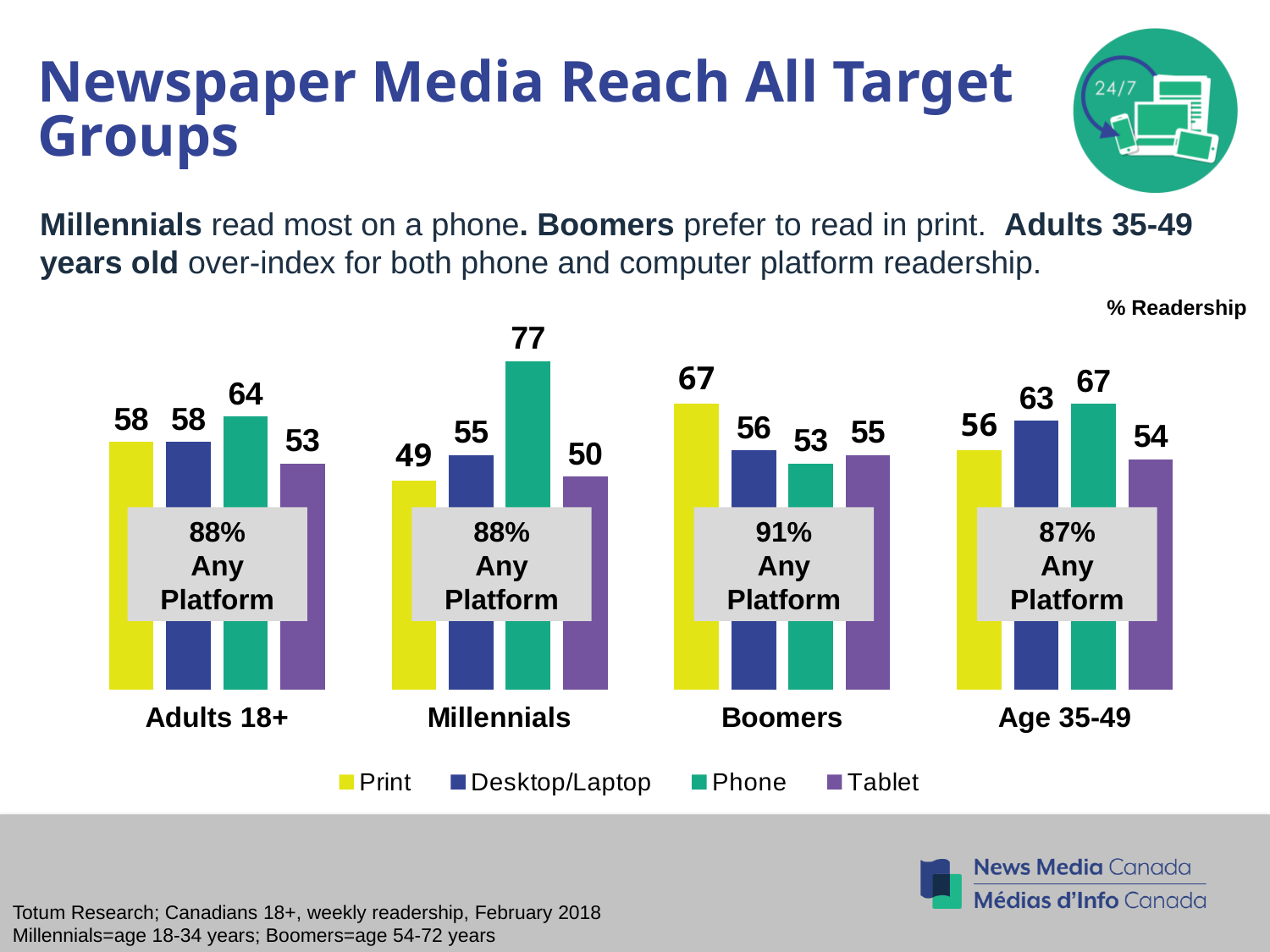
What is the Desktop/Laptop readership value for Age 35-49? 63 How many series does the chart legend list? 4 What is the difference between the Phone and Print readership values for Millennials? 28 What is the Tablet readership value for Adults 18+? 53 What is the Phone readership value for Millennials? 77 Which platform has the highest readership among Millennials? Phone How many age groups are shown on the x axis of the chart? 4 Which platform has the lowest readership among Boomers? Phone What is the Print readership value for Boomers? 67 What kind of chart is shown on the slide? Bar chart Which is larger for Age 35-49: the Print value or the Phone value? Phone What is the 'Any Platform' readership percentage shown for Boomers? 91%